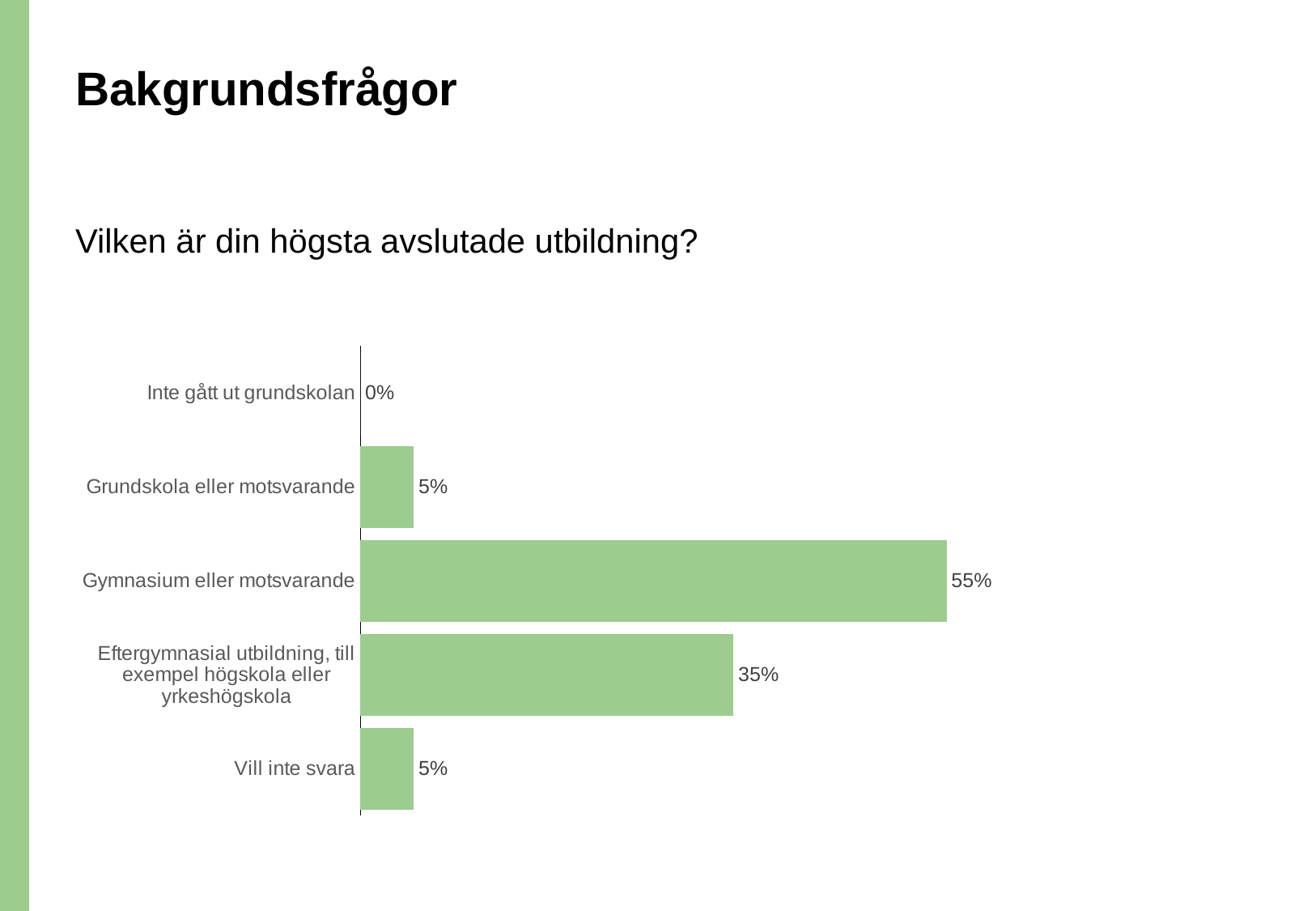
What is the difference between the values for Grundskola eller motsvarande and Inte gått ut grundskolan? 5% Which category has the lowest value? Inte gått ut grundskolan What question does the chart on the slide answer? Vilken är din högsta avslutade utbildning? What kind of chart is shown on the slide? Bar chart What is the value for Gymnasium eller motsvarande? 55% What is the value for Grundskola eller motsvarande? 5% How many categories are shown in the chart? 5 What is the difference between the values for Gymnasium eller motsvarande and Eftergymnasial utbildning, till exempel högskola eller yrkeshögskola? 20% What is the value for Eftergymnasial utbildning, till exempel högskola eller yrkeshögskola? 35% What is the value for Inte gått ut grundskolan? 0% Which category has the highest value? Gymnasium eller motsvarande Which is larger, the value for Eftergymnasial utbildning or the value for Vill inte svara? Eftergymnasial utbildning